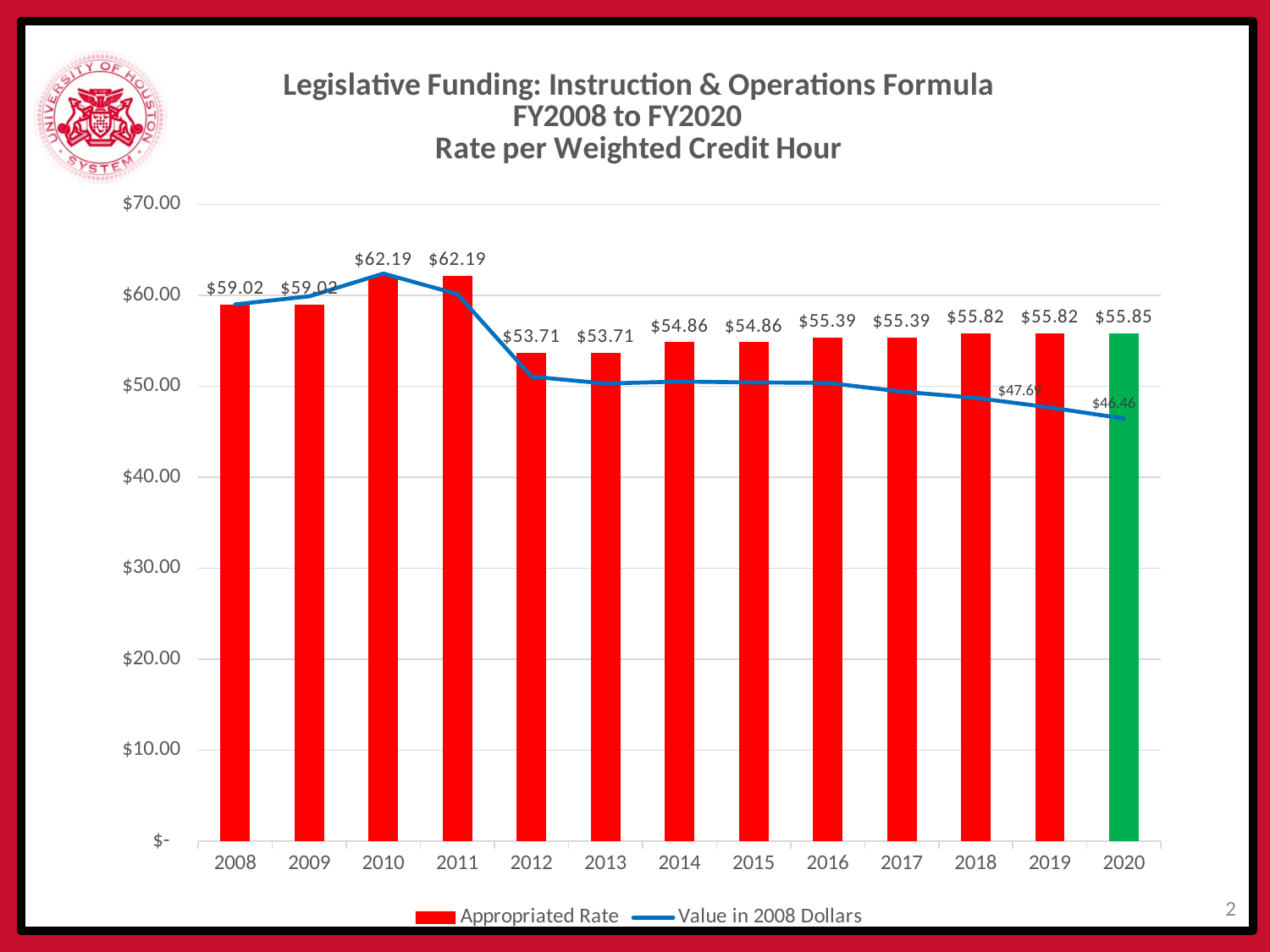
What is the difference between the Appropriated Rate in 2011 and in 2012? $8.48 How many years are shown on the x axis? 13 How many series does the legend list? 2 What is the Appropriated Rate for 2020? $55.85 What kind of chart is used for the Appropriated Rate series? Bar chart Which year has the lowest Appropriated Rate? 2012 and 2013 What is the Value in 2008 Dollars for 2020? $46.46 Does the Value in 2008 Dollars line rise or fall from 2011 to 2020? Fall Is the Value in 2008 Dollars for 2010 greater or less than $60.00? greater What is the highest Appropriated Rate shown on the chart? $62.19 Which is larger, the Appropriated Rate in 2008 or in 2016? 2008 What is the Appropriated Rate for 2010? $62.19